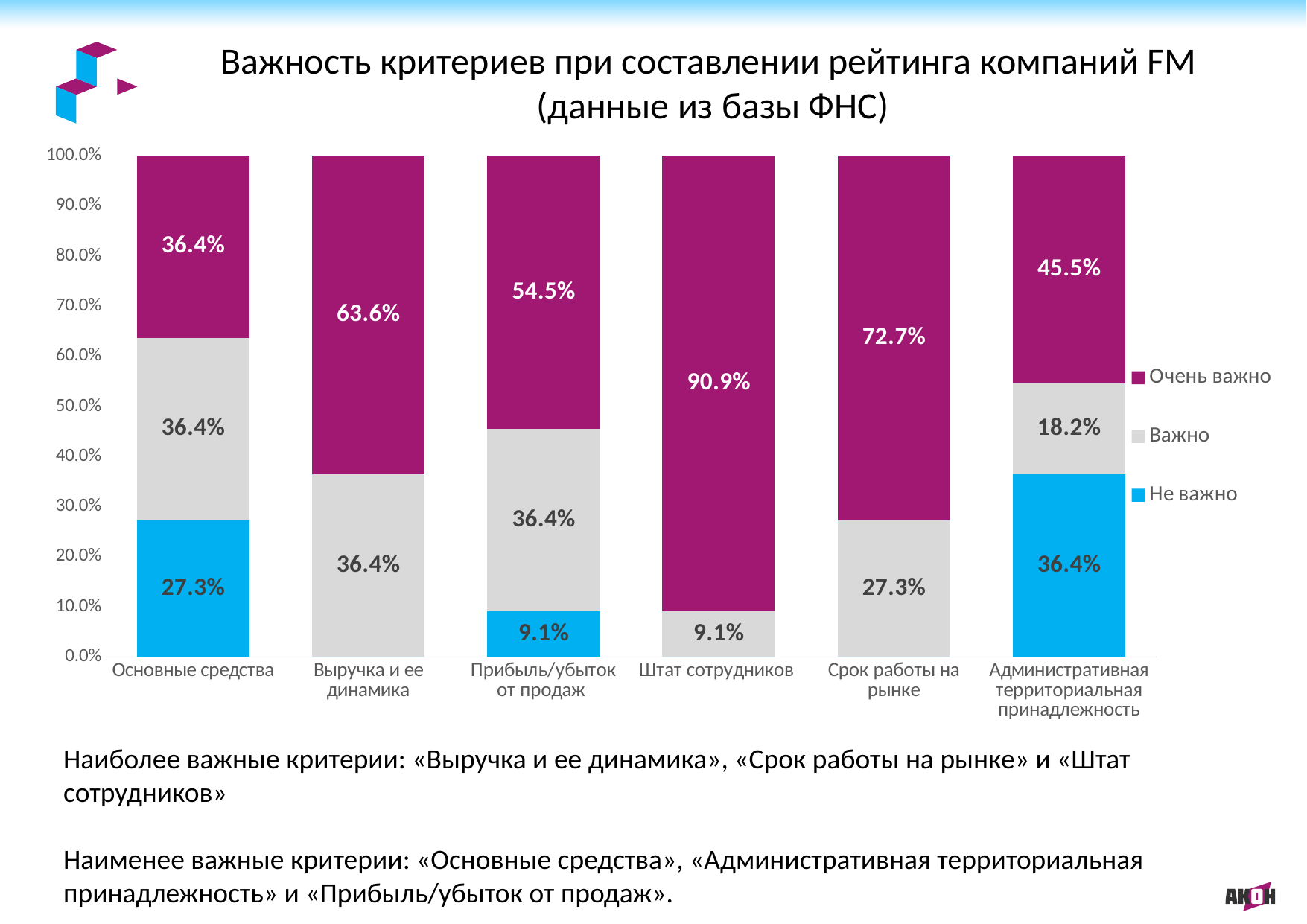
Which legend entry is shown in blue? Не важно Which is larger: the «Не важно» value for «Основные средства» or for «Прибыль/убыток от продаж»? Основные средства What is the «Важно» value for «Срок работы на рынке»? 27.3% How many series does the legend list? 3 What type of chart is shown on the slide? Stacked bar chart What is the «Очень важно» value for «Прибыль/убыток от продаж»? 54.5% Which category has the highest «Очень важно» share? Штат сотрудников What is the difference between the «Очень важно» values for «Срок работы на рынке» and «Выручка и ее динамика»? 9.1% Which category has the lowest «Очень важно» share? Основные средства What share of respondents rated «Штат сотрудников» as «Очень важно»? 90.9% How many categories are shown on the x axis? 6 What is the «Не важно» value for «Административная территориальная принадлежность»? 36.4%